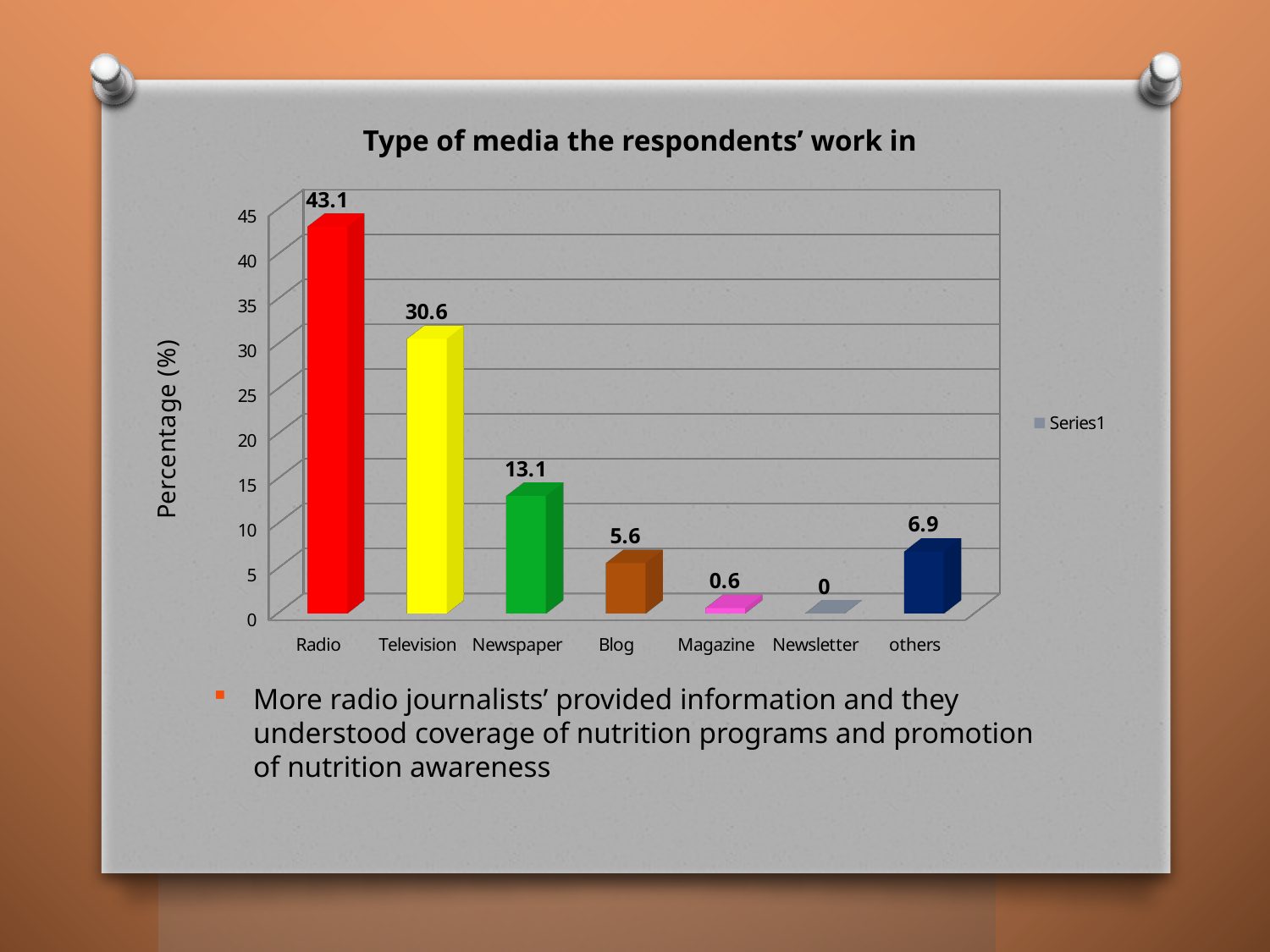
What is the value for Radio? 43.1 What is the value for Television? 30.6 What kind of chart is shown on the slide? Bar chart How many categories are shown on the x axis? 7 How many series does the legend list? 1 What is the value for Newsletter? 0 What is the title of the chart? Type of media the respondents' work in Which is larger, the value for Blog or the value for others? others Which category has the highest value? Radio What is the difference between the values for Radio and Television? 12.5 What is the value for Newspaper? 13.1 Which category has the lowest value? Newsletter